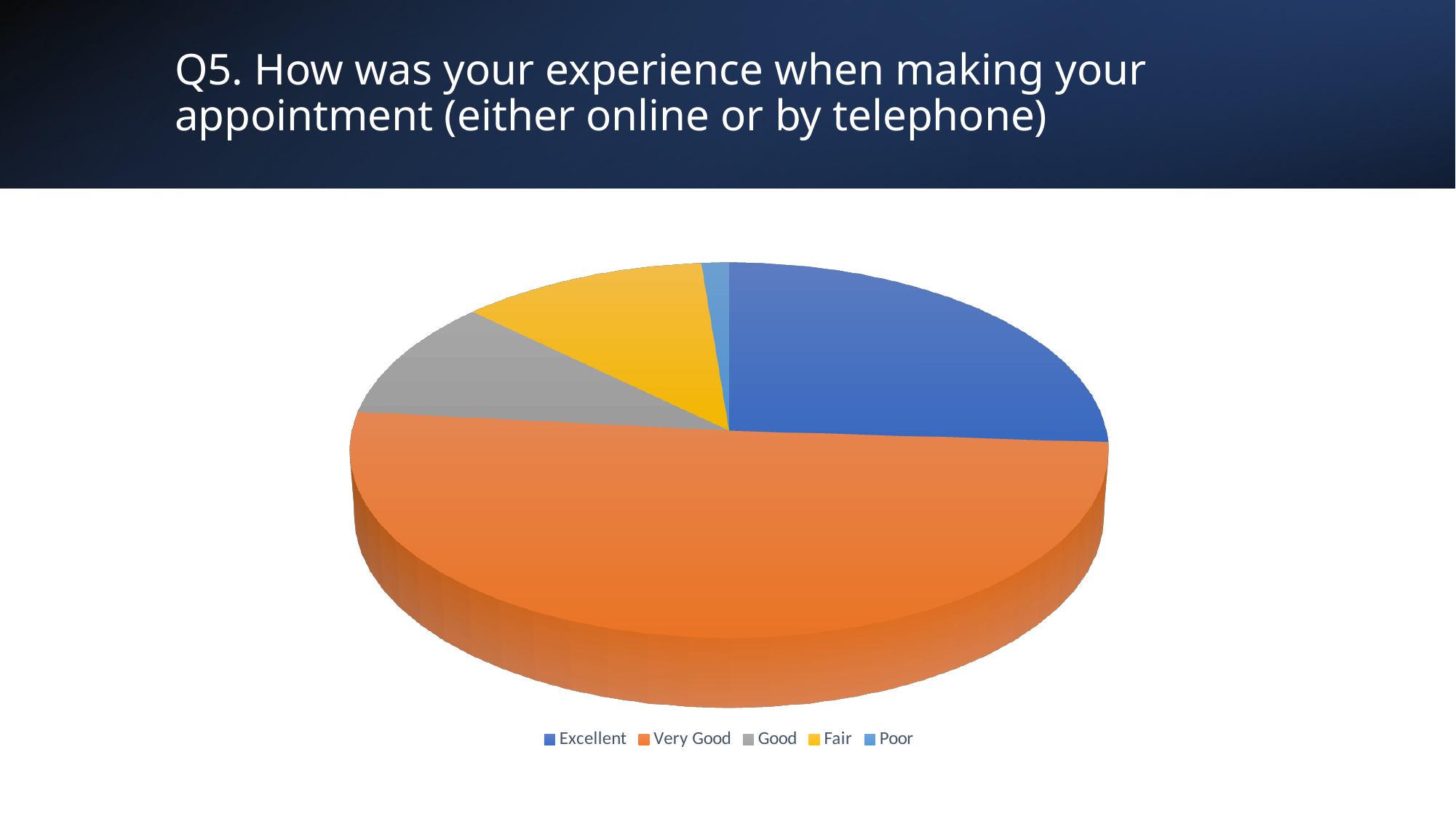
How many categories does the pie chart show? 5 Which category has the largest slice of the pie? Very Good Which category has the second-largest slice of the pie? Excellent What colour is the Very Good slice in the pie chart? Orange Which slice is larger, Excellent or Poor? Excellent What is the first category listed in the legend? Excellent Which slice is larger, Good or Poor? Good Which category has the smallest slice of the pie? Poor Which slice is larger, Excellent or Fair? Excellent What kind of chart is shown on the slide? Pie chart